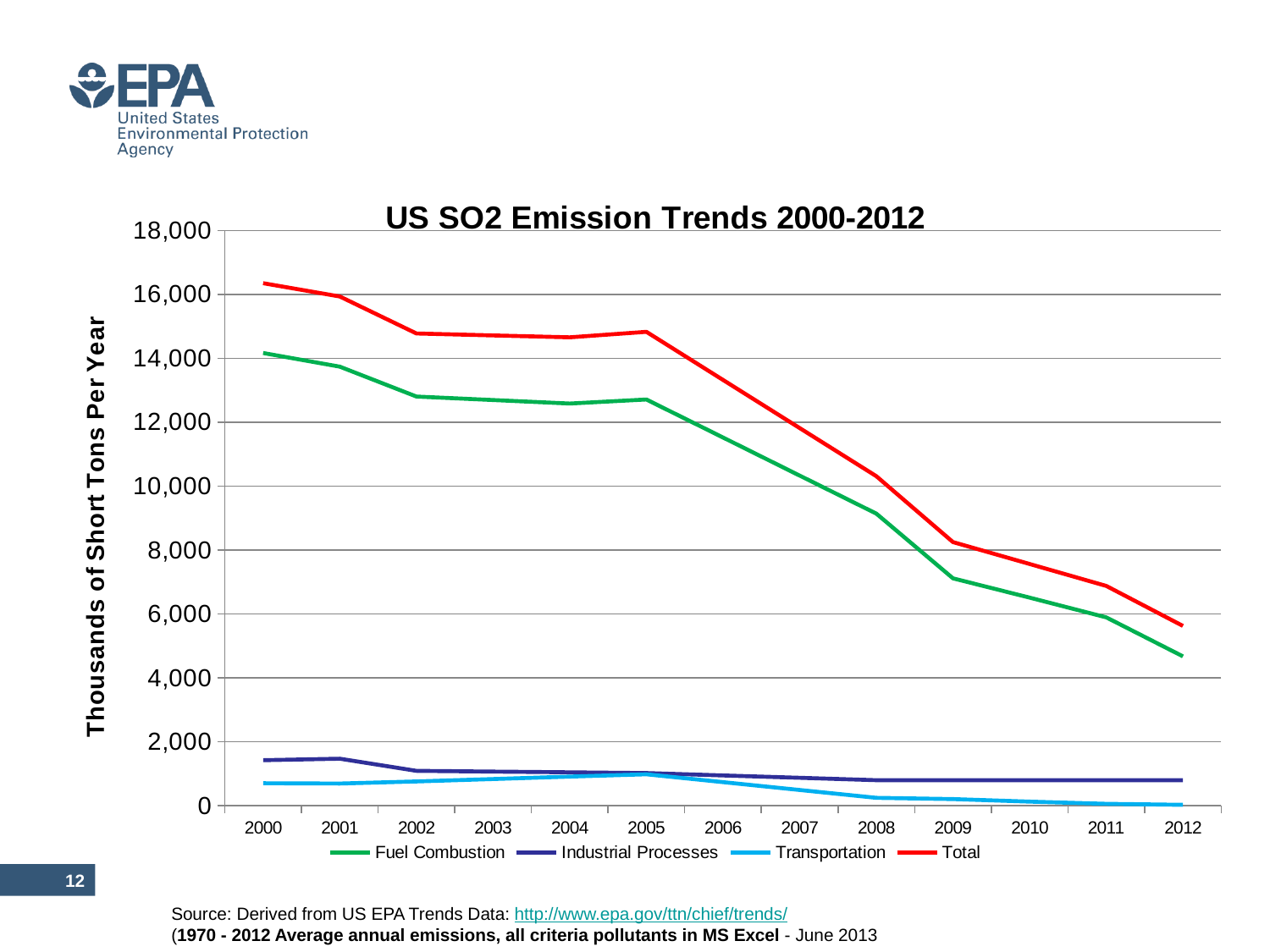
How many years are plotted along the x axis? 13 What kind of chart is shown on the slide? line chart In which year is the Total series at its highest? 2000 In which year is the Fuel Combustion series at its lowest? 2012 Does the Total series rise or fall from 2000 to 2012? fall How many series does the legend list? 4 Is the Industrial Processes value for 2000 greater or less than 2,000? less Is the Fuel Combustion value for 2012 greater or less than 6,000? less Which series has the highest value in 2000? Total What is the label on the vertical axis? Thousands of Short Tons Per Year In 2005, which is larger: Fuel Combustion or Industrial Processes? Fuel Combustion Is the Total value for 2000 greater or less than 16,000? greater